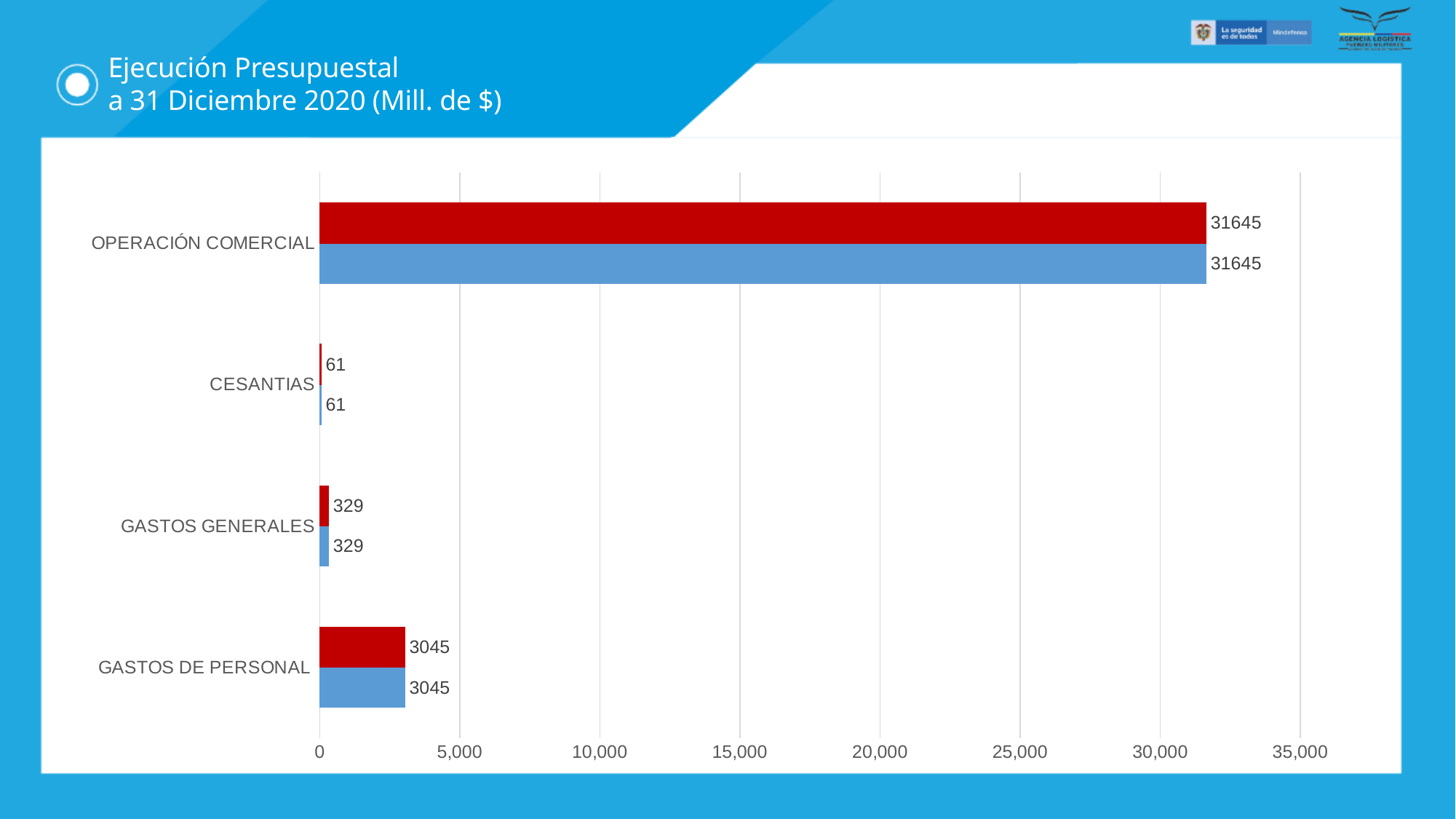
What is the value of the blue bar for GASTOS DE PERSONAL? 3045 Which category has the highest value? OPERACIÓN COMERCIAL What is the title of the slide containing the chart? Ejecución Presupuestal a 31 Diciembre 2020 (Mill. de $) What is the value of the red bar for OPERACIÓN COMERCIAL? 31645 What kind of chart is shown on the slide? bar chart What is the value of the blue bar for CESANTIAS? 61 What is the value of the red bar for GASTOS GENERALES? 329 Which category has the lowest value? CESANTIAS Is the value for OPERACIÓN COMERCIAL greater or less than 30,000? greater Which is larger, the red bar for GASTOS GENERALES or the red bar for CESANTIAS? GASTOS GENERALES What is the difference between the red bar values for GASTOS DE PERSONAL and GASTOS GENERALES? 2716 How many categories are shown on the chart? 4